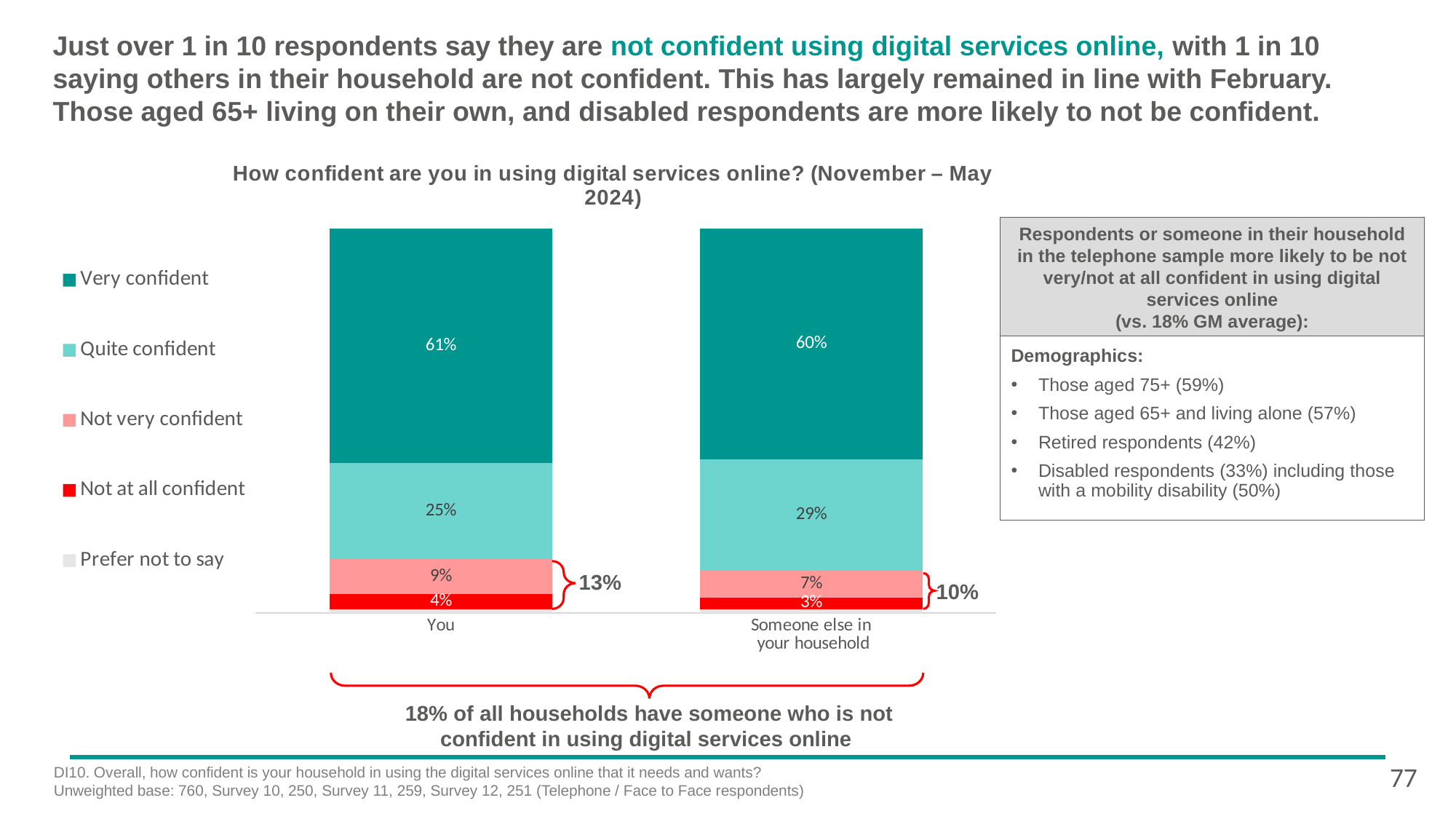
How many bars are plotted in the chart? 2 What percentage is shown for 'Not very confident' in the 'Someone else in your household' bar? 7% Which bar has the higher 'Not very confident' value, 'You' or 'Someone else in your household'? You What combined percentage is shown by the bracket next to the 'Not very confident' and 'Not at all confident' segments of the 'You' bar? 13% What percentage is shown for 'Quite confident' in the 'Someone else in your household' bar? 29% What kind of chart is shown on the slide? Stacked bar chart What percentage is shown for 'Not at all confident' in the 'You' bar? 4% What is the difference between the 'Quite confident' values for 'Someone else in your household' and 'You'? 4% How many series does the legend list? 5 What percentage of respondents say they are 'Very confident' for the 'You' bar? 61% Which segment is the largest in the 'You' bar? Very confident